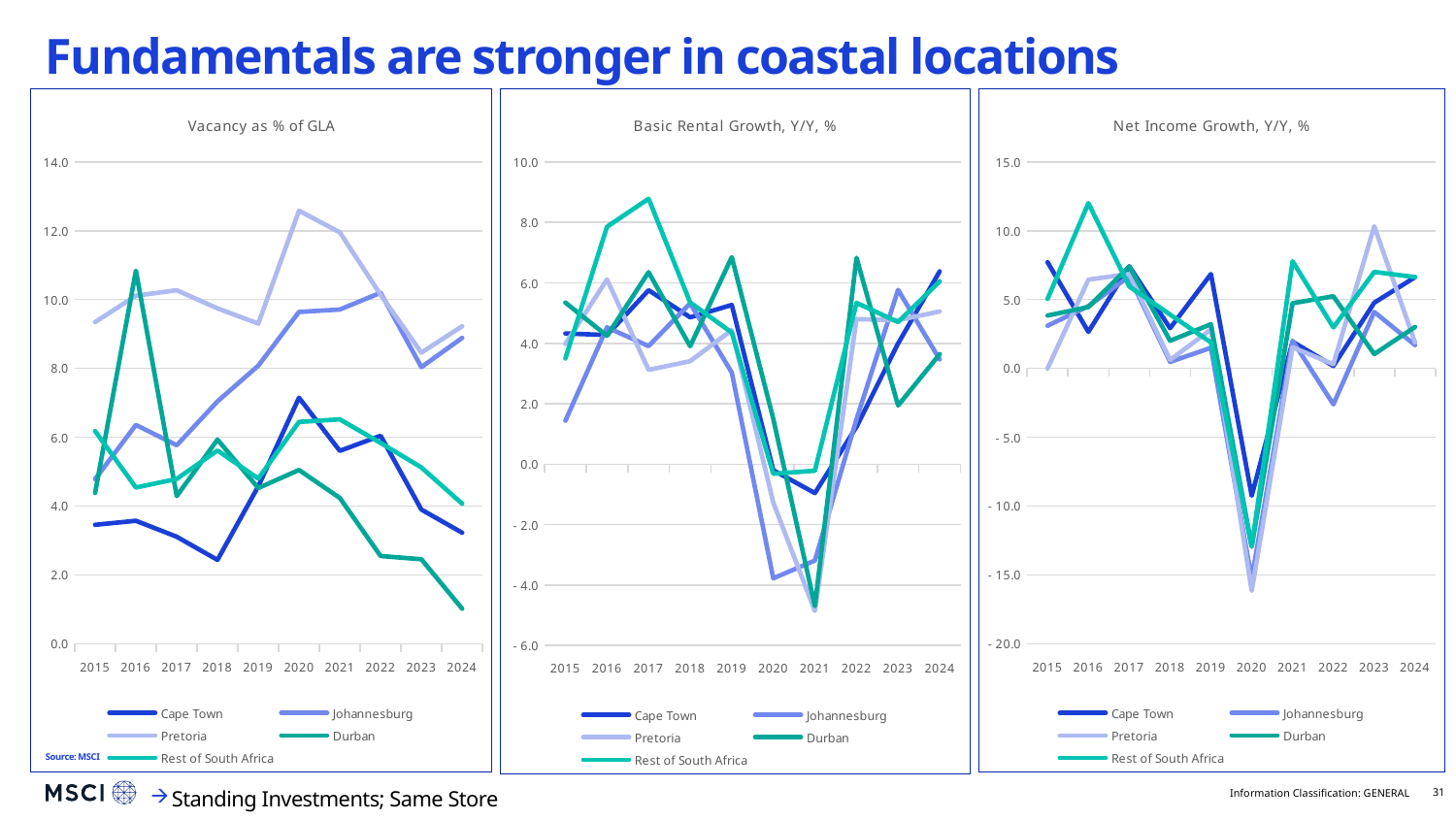
In the 'Vacancy as % of GLA' chart, which is larger in 2024: Pretoria or Durban? Pretoria In the 'Vacancy as % of GLA' chart, is the value for Pretoria in 2020 greater or less than 12.0? greater In the 'Net Income Growth, Y/Y, %' chart, is the value for Rest of South Africa in 2016 greater or less than 10.0? greater In the 'Basic Rental Growth, Y/Y, %' chart, do the values for Cape Town rise or fall from 2019 to 2021? fall In the 'Vacancy as % of GLA' chart, in which year is Durban's vacancy lowest? 2024 In the 'Net Income Growth, Y/Y, %' chart, is the value for Pretoria in 2020 greater or less than -15.0? less In the 'Vacancy as % of GLA' chart, in which year does Pretoria reach its highest vacancy? 2020 In the 'Vacancy as % of GLA' chart, what kind of chart is shown? line chart In the 'Vacancy as % of GLA' chart, how many series does the legend list? 5 In the 'Basic Rental Growth, Y/Y, %' chart, how many years are plotted on the x axis? 10